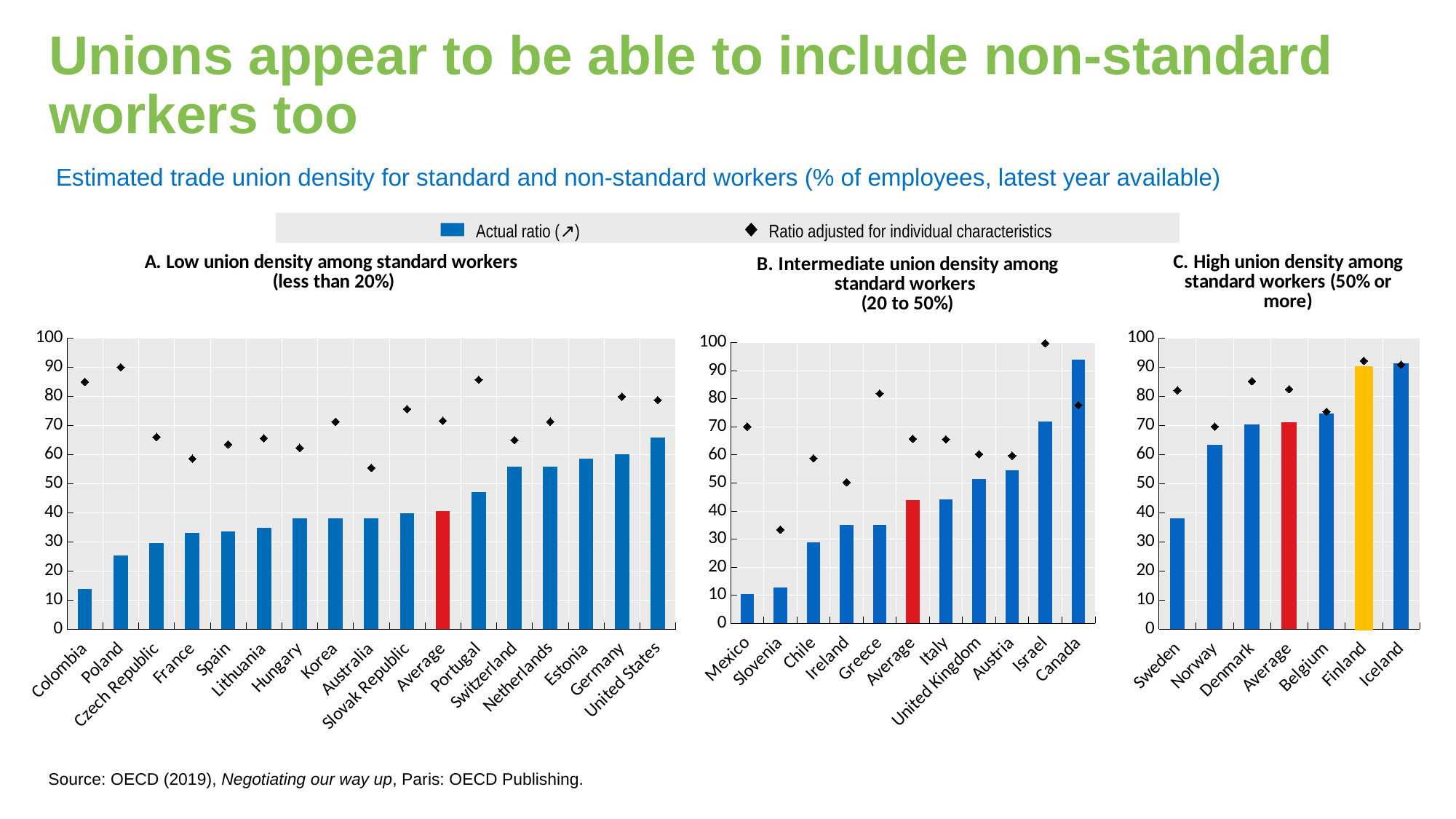
In chart B (Intermediate union density among standard workers), how many categories are shown on the x axis? 11 In chart A (Low union density among standard workers), is the actual ratio bar for Colombia greater or less than 20? less In chart A (Low union density among standard workers), do the actual ratio bars rise or fall from left to right? rise In chart A (Low union density among standard workers), which has the larger actual ratio bar, Poland or Portugal? Portugal In chart A (Low union density among standard workers), which country has the highest actual ratio bar? United States In chart A (Low union density among standard workers), which country has the lowest actual ratio bar? Colombia In chart B (Intermediate union density among standard workers), is the actual ratio bar for Mexico greater or less than 20? less In chart A (Low union density among standard workers), how many categories are shown on the x axis? 17 In chart B (Intermediate union density among standard workers), which country has the highest actual ratio bar? Canada In chart C (High union density among standard workers), which country has the lowest actual ratio bar? Sweden How many series does the legend above the charts list? 2 In chart C (High union density among standard workers), what colour is the bar for Finland? Yellow